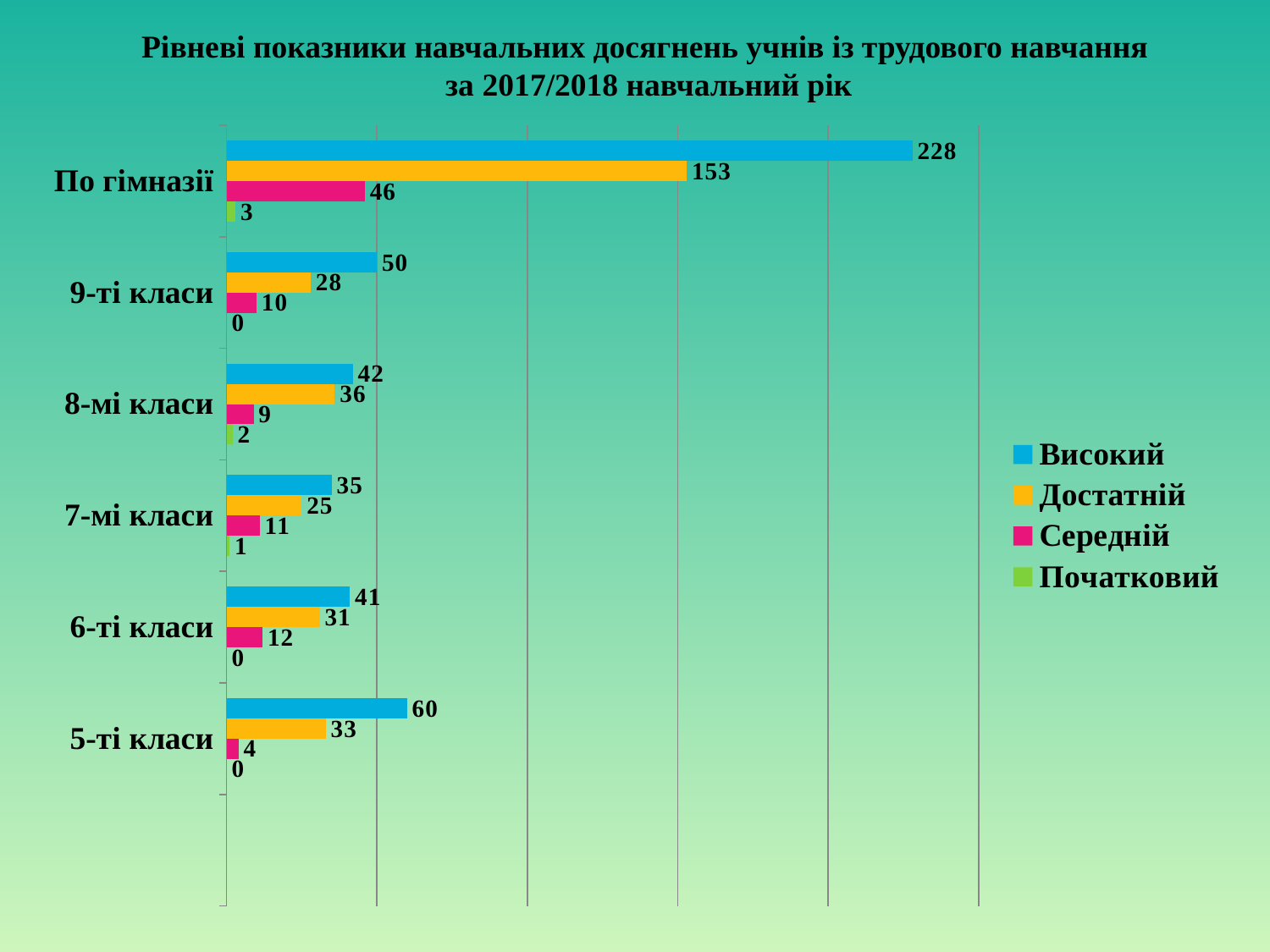
Among the class groups (excluding По гімназії), which category has the highest Високий value? 5-ті класи What is the value for Достатній for По гімназії? 153 What is the value for Високий for 5-ті класи? 60 Which category has the lowest Середній value? 5-ті класи Which is larger for 8-мі класи: Високий or Достатній? Високий What is the value for Початковий for 8-мі класи? 2 What is the difference between the Високий and Достатній values for По гімназії? 75 How many series does the legend list? 4 Which colour represents the Середній series? pink What kind of chart is shown on the slide? bar chart What is the value for Середній for 6-ті класи? 12 How many categories are shown on the chart? 6